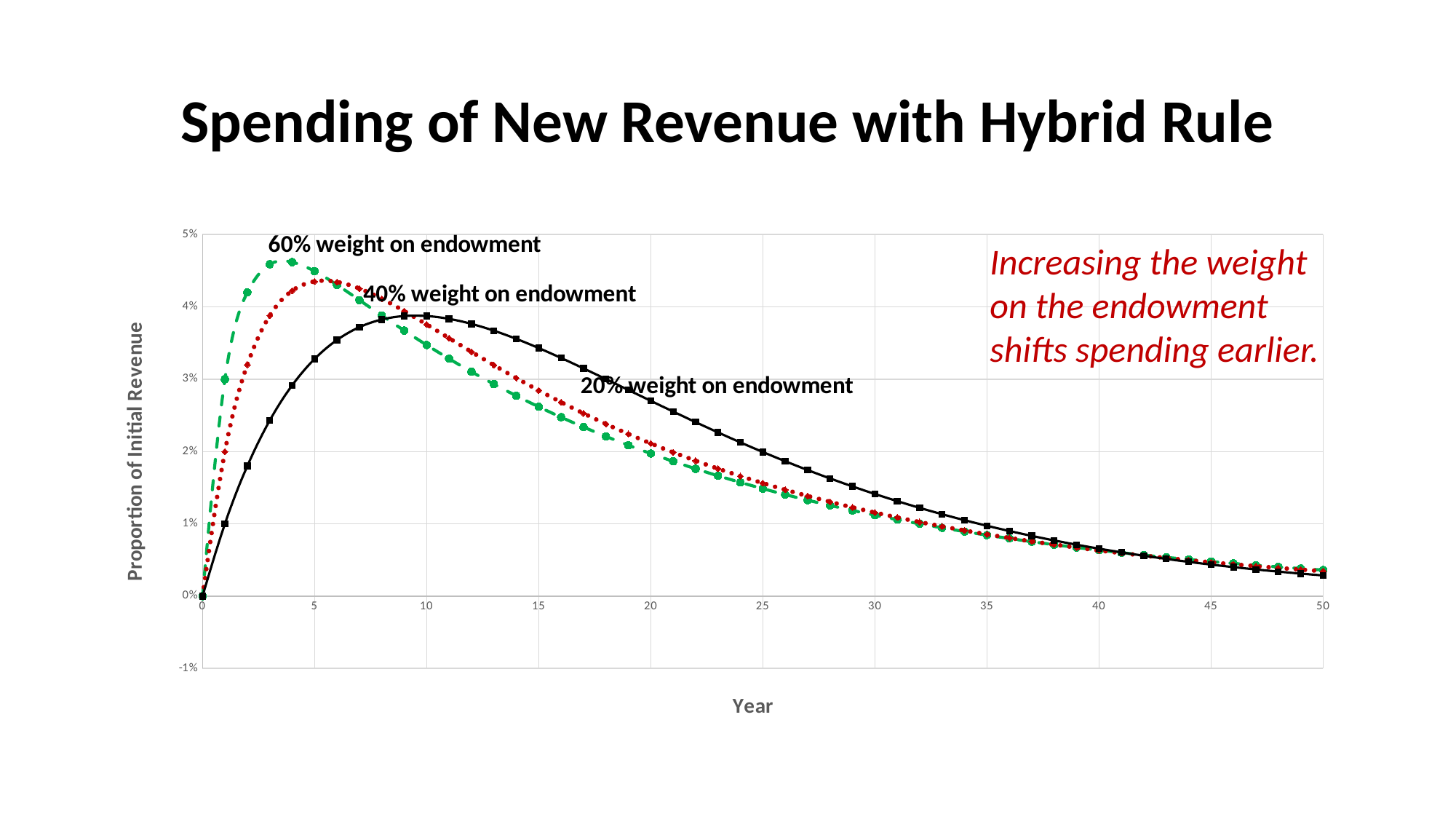
Is the peak value of the 60% weight on endowment series greater or less than 4%? greater Is the value of the 20% weight on endowment series at year 10 greater or less than 3%? greater Which series reaches its peak latest along the Year axis? 20% weight on endowment How many series are plotted on the chart? 3 Is the value of the 60% weight on endowment series at year 25 greater or less than 2%? less Does the 20% weight on endowment series rise or fall between year 10 and year 50? fall What kind of chart is shown on the slide? line chart Which series reaches the highest peak value? 60% weight on endowment What is the value of all three series at year 0? 0% What is the title of the chart on the slide? Spending of New Revenue with Hybrid Rule What is the label of the vertical axis? Proportion of Initial Revenue